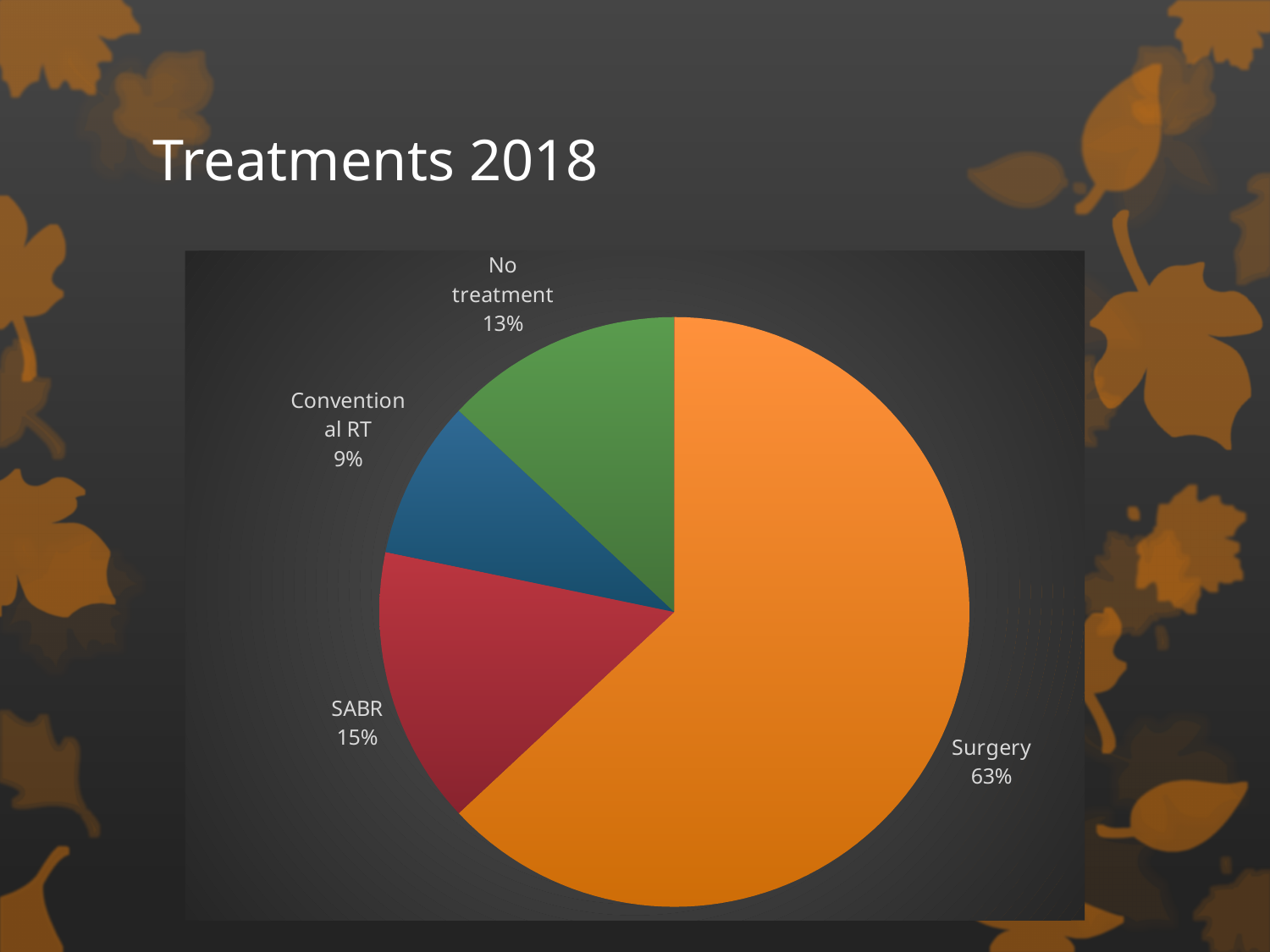
What kind of chart is shown on the slide? Pie chart Which category has the smallest slice of the pie? Conventional RT Which category has the largest slice of the pie? Surgery How many categories are shown in the pie chart? 4 What is the difference in percentage points between No treatment and Conventional RT? 4 What is the value shown for Conventional RT? 9% What is the difference in percentage points between Surgery and SABR? 48 What is the value shown for SABR? 15% What is the value shown for No treatment? 13% Which is larger, the share for SABR or the share for No treatment? SABR What is the title of the slide containing the chart? Treatments 2018 What share of the pie does Surgery account for? 63%